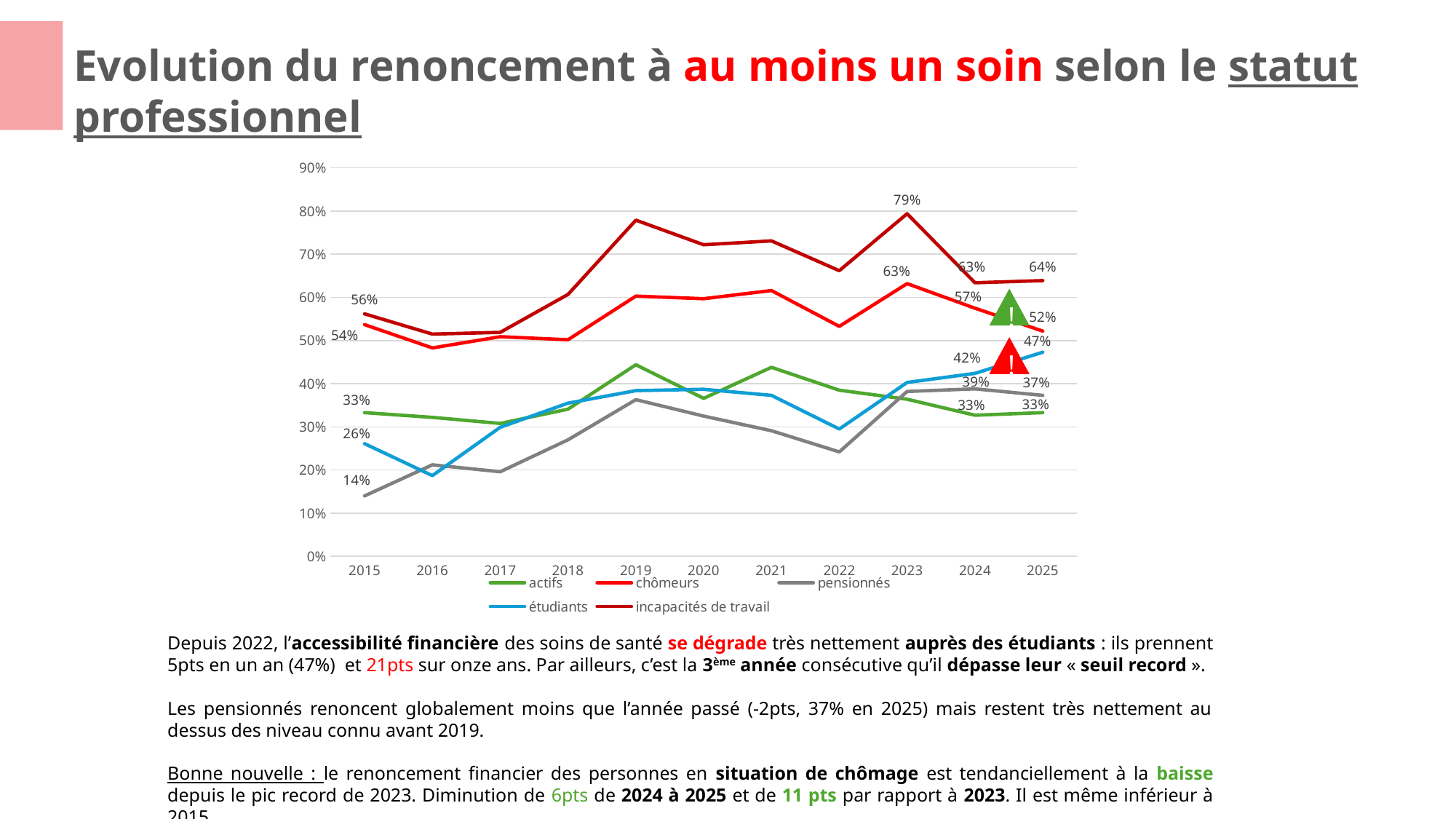
What is the value for 'étudiants' in 2025? 47% How many series does the chart legend list? 5 What type of chart is shown on the slide? line chart Which series has the highest value in 2025? incapacités de travail Is the value for 'incapacités de travail' in 2019 greater or less than 70%? greater What is the value for 'chômeurs' in 2024? 57% By how many percentage points did the value for 'étudiants' change between 2015 (26%) and 2025 (47%)? 21 points Which series has the lowest value in 2015? pensionnés In 2025, which is larger: the value for 'étudiants' or the value for 'pensionnés'? étudiants What is the value for 'incapacités de travail' in 2023? 79% What is the value for 'pensionnés' in 2015? 14% How many years are shown on the x axis of the chart? 11